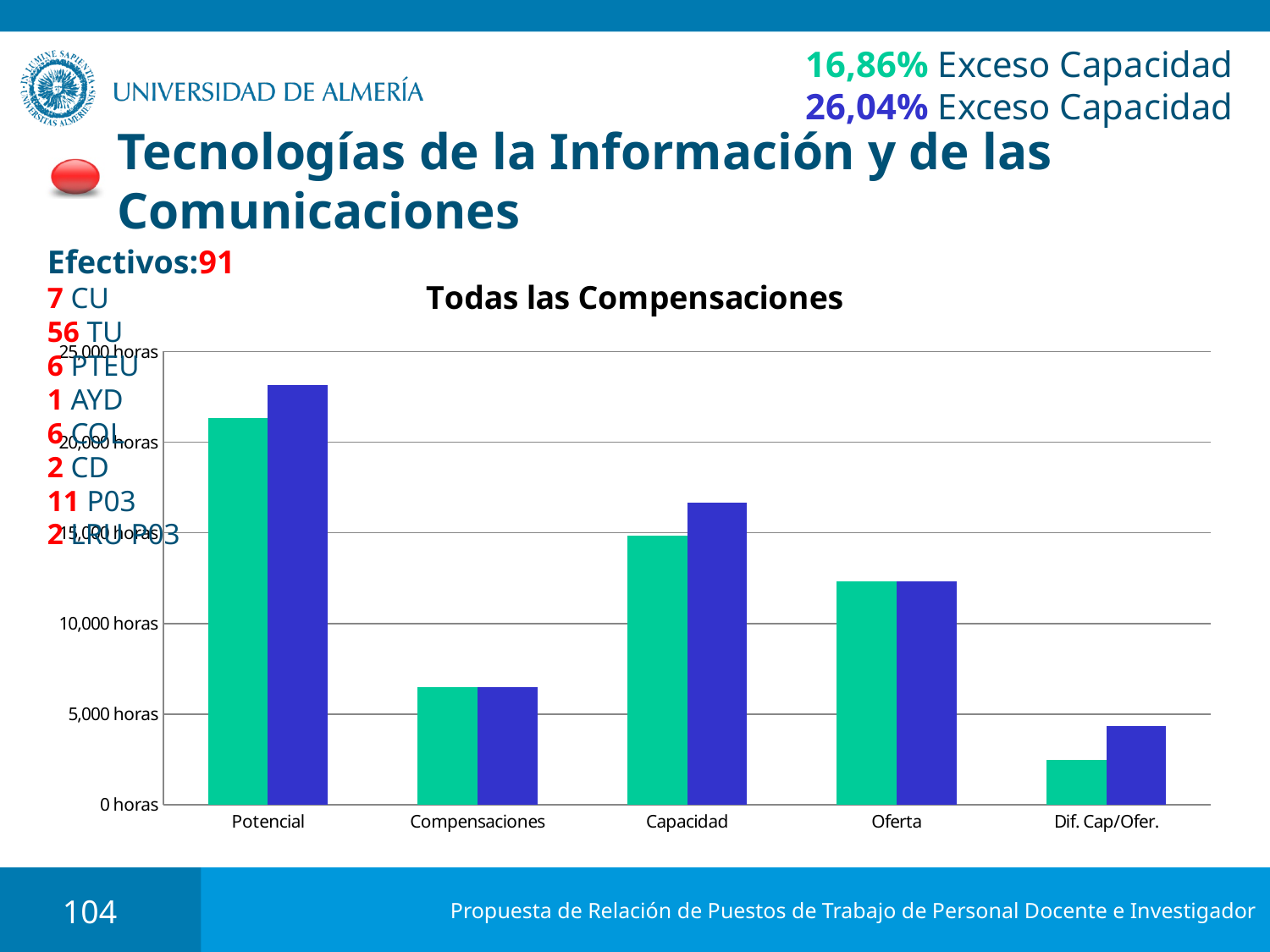
Is the value of the green bar for Potencial greater or less than 20,000 horas? greater What kind of chart is shown on the slide? bar chart Which is larger, the green bar for Potencial or the green bar for Compensaciones? Potencial Is the value of the blue bar for Capacidad greater or less than 15,000 horas? greater Is the value of the green bar for Compensaciones greater or less than 10,000 horas? less How many bars are plotted for each category in the chart? 2 How many categories are shown on the x axis of the chart? 5 What is the title of the chart? Todas las Compensaciones Which is larger, the blue bar for Capacidad or the blue bar for Oferta? Capacidad Which category has the tallest bars in the chart? Potencial Which category has the shortest bars in the chart? Dif. Cap/Ofer.